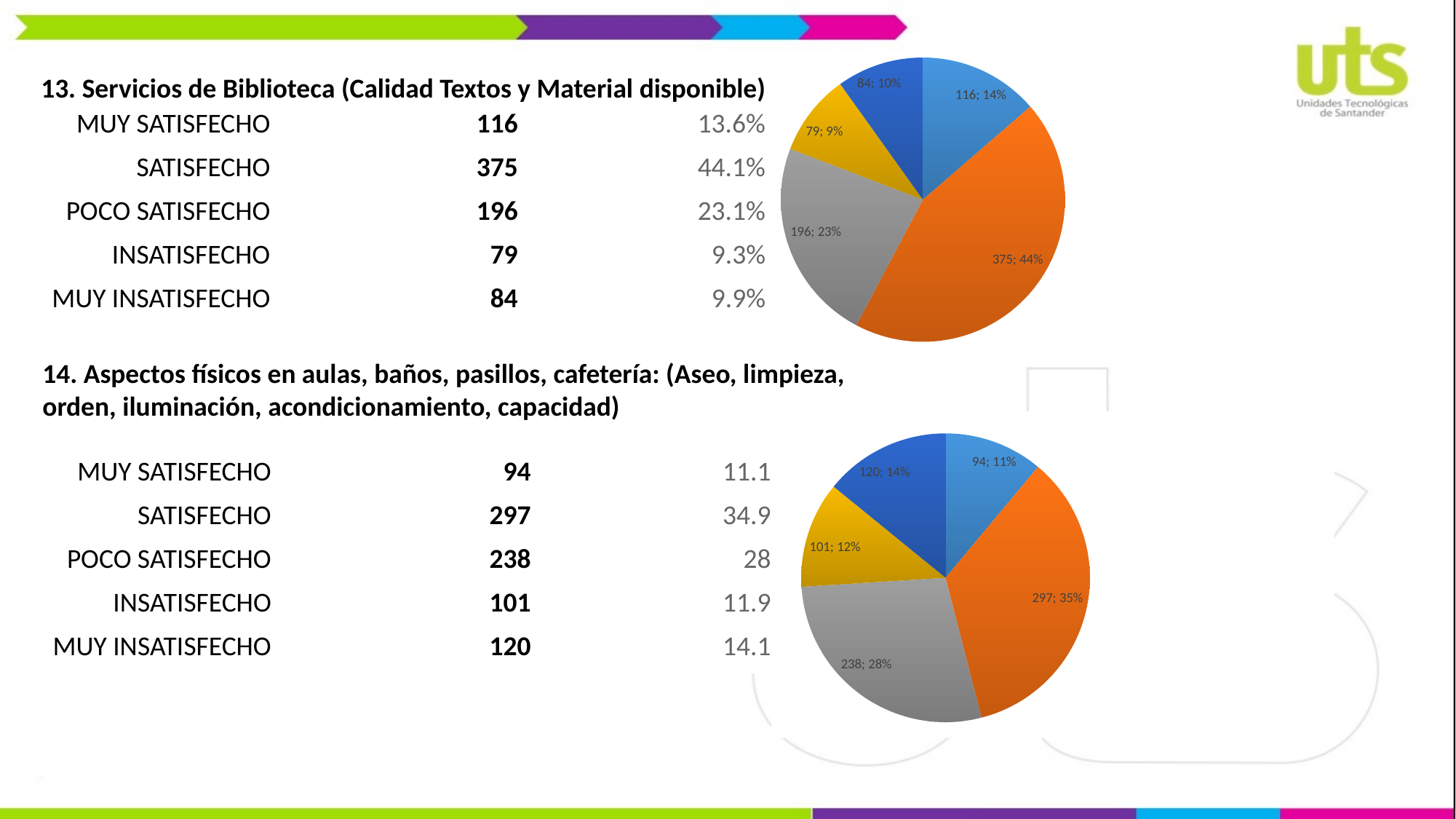
In the bottom pie chart (Aspectos físicos), what percentage share does the 238 slice represent? 28% In the top pie chart (Servicios de Biblioteca), what is the difference between the 196 slice and the 116 slice? 80 In the bottom pie chart (Aspectos físicos), what is the value of the largest slice? 297 In the top pie chart (Servicios de Biblioteca), what percentage share is shown for the slice with value 196? 23% In the top pie chart (Servicios de Biblioteca), what is the value of the smallest slice? 79 How many slices does the top pie chart (Servicios de Biblioteca) have? 5 In the top pie chart (Servicios de Biblioteca), what percentage share does the 375 slice represent? 44% What type of chart is shown next to item 13 (Servicios de Biblioteca)? pie chart In the top pie chart (Servicios de Biblioteca), what is the value of the largest slice? 375 In the bottom pie chart (Aspectos físicos), which slice is larger: the one with value 120 or the one with value 101? 120 In the bottom pie chart (Aspectos físicos), what is the difference between the 297 slice and the 238 slice? 59 In the bottom pie chart (Aspectos físicos), what is the value of the smallest slice? 94